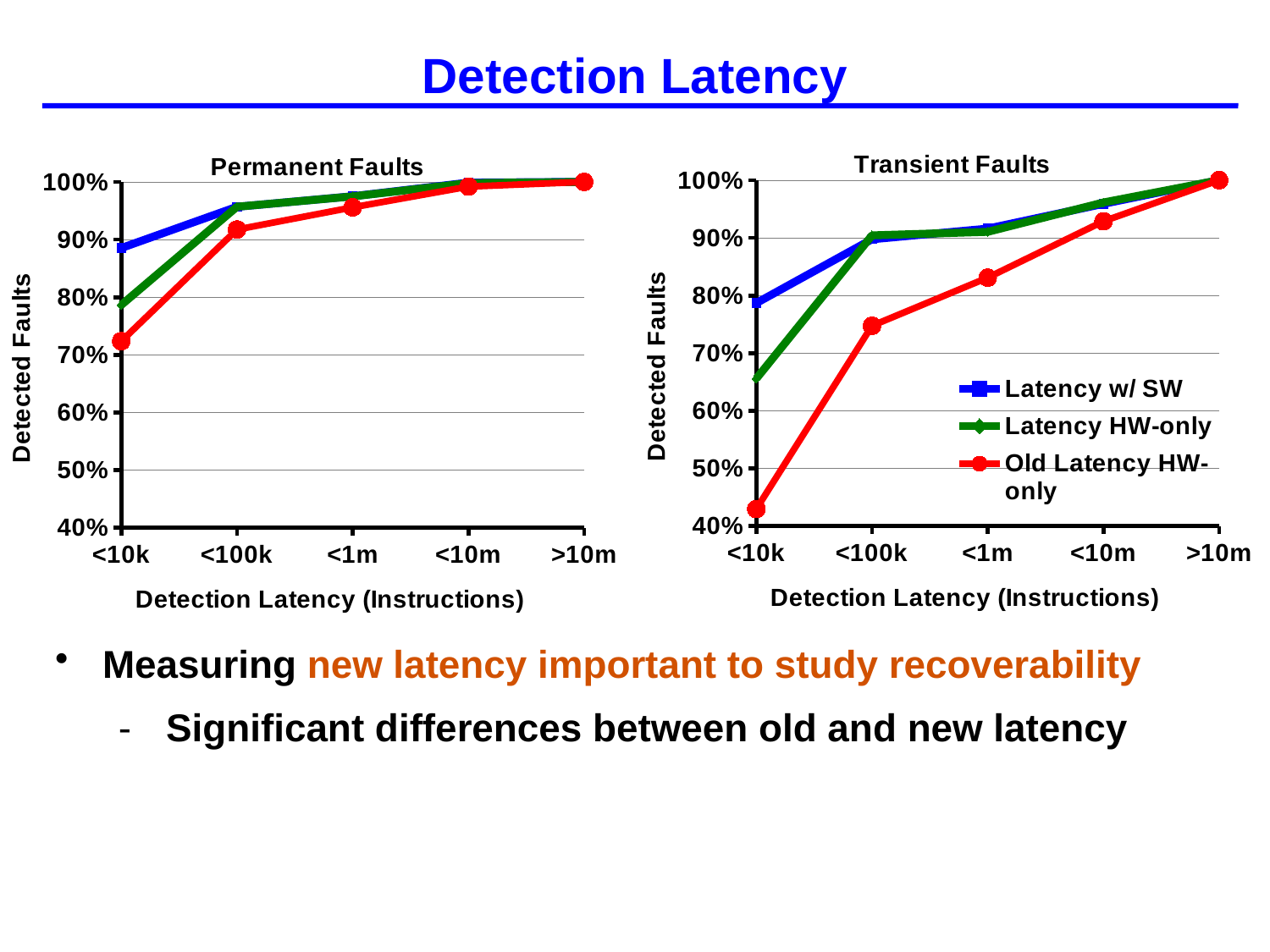
In the Transient Faults chart, which series has the lowest value at <10k? Old Latency HW-only In the Transient Faults chart, is the value for Old Latency HW-only at <10k greater or less than 50%? less How many series does the legend on the Transient Faults chart list? 3 In the Permanent Faults chart, is the value for Latency w/ SW at <10k greater or less than 80%? greater In the Permanent Faults chart, do the values for Old Latency HW-only rise or fall from <10k to >10m? rise In the Permanent Faults chart, is the value for Old Latency HW-only at <10k greater or less than 80%? less How many detection latency categories are shown on the x axis of the Permanent Faults chart? 5 What is the y-axis label on the Transient Faults chart? Detected Faults In the Transient Faults chart, at <10k, which is larger: Latency w/ SW or Old Latency HW-only? Latency w/ SW What type of chart is the Permanent Faults chart? line chart